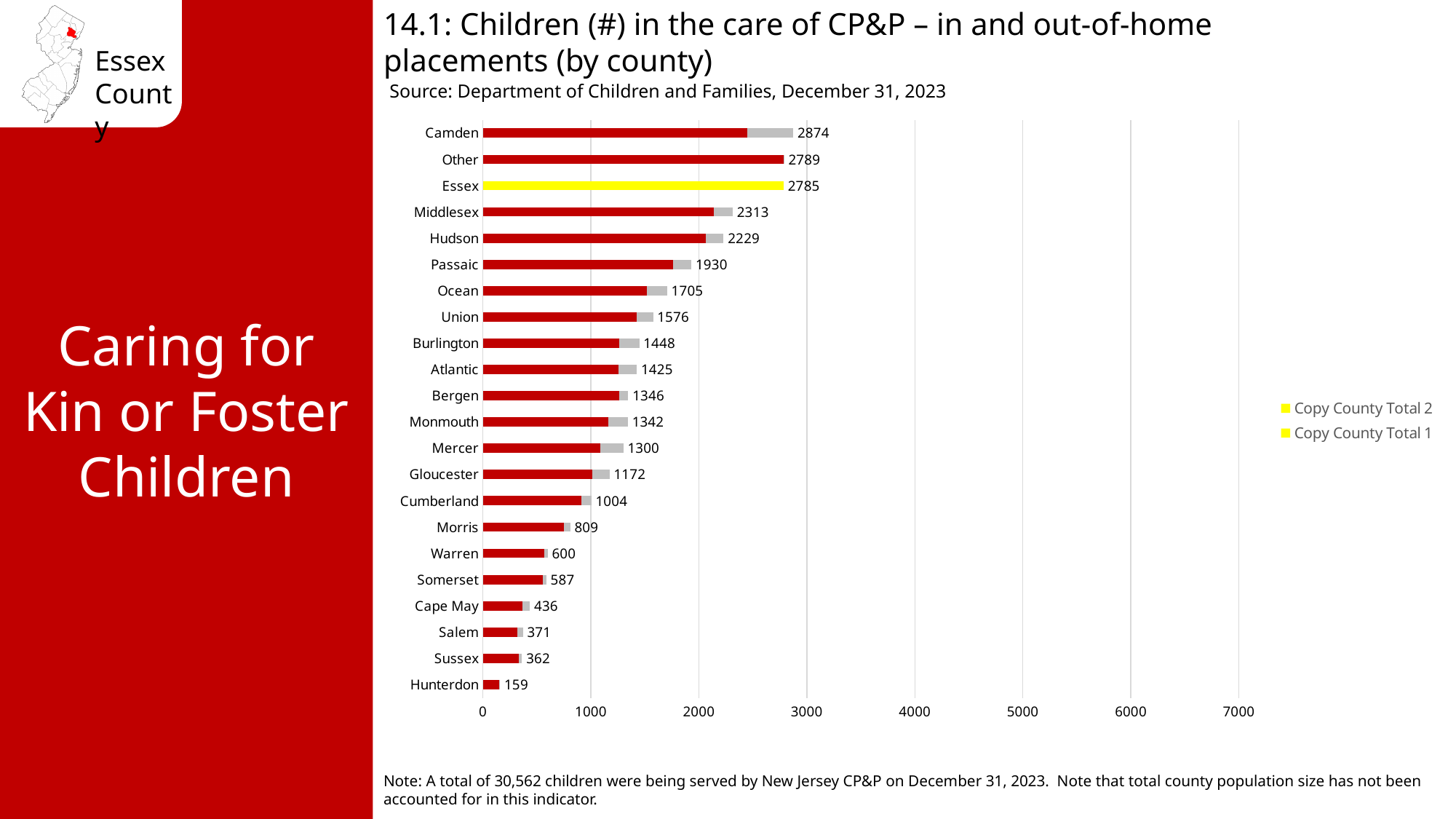
Is the value for Essex greater or less than 2000? greater What kind of chart is used on this slide? Bar chart What value is shown for Cumberland County? 1004 How many counties (categories) are shown on the chart? 22 What value is shown for Hudson County? 2229 Which county's bar is highlighted in yellow? Essex Which county has the lowest number of children in the care of CP&P? Hunterdon What is the total number of children in the care of CP&P for Essex County? 2785 Which has a larger value, Middlesex or Union? Middlesex What is the difference between the values for Camden and Essex? 89 Which county has the highest number of children in the care of CP&P? Camden What is the difference between the values for Passaic and Ocean? 225